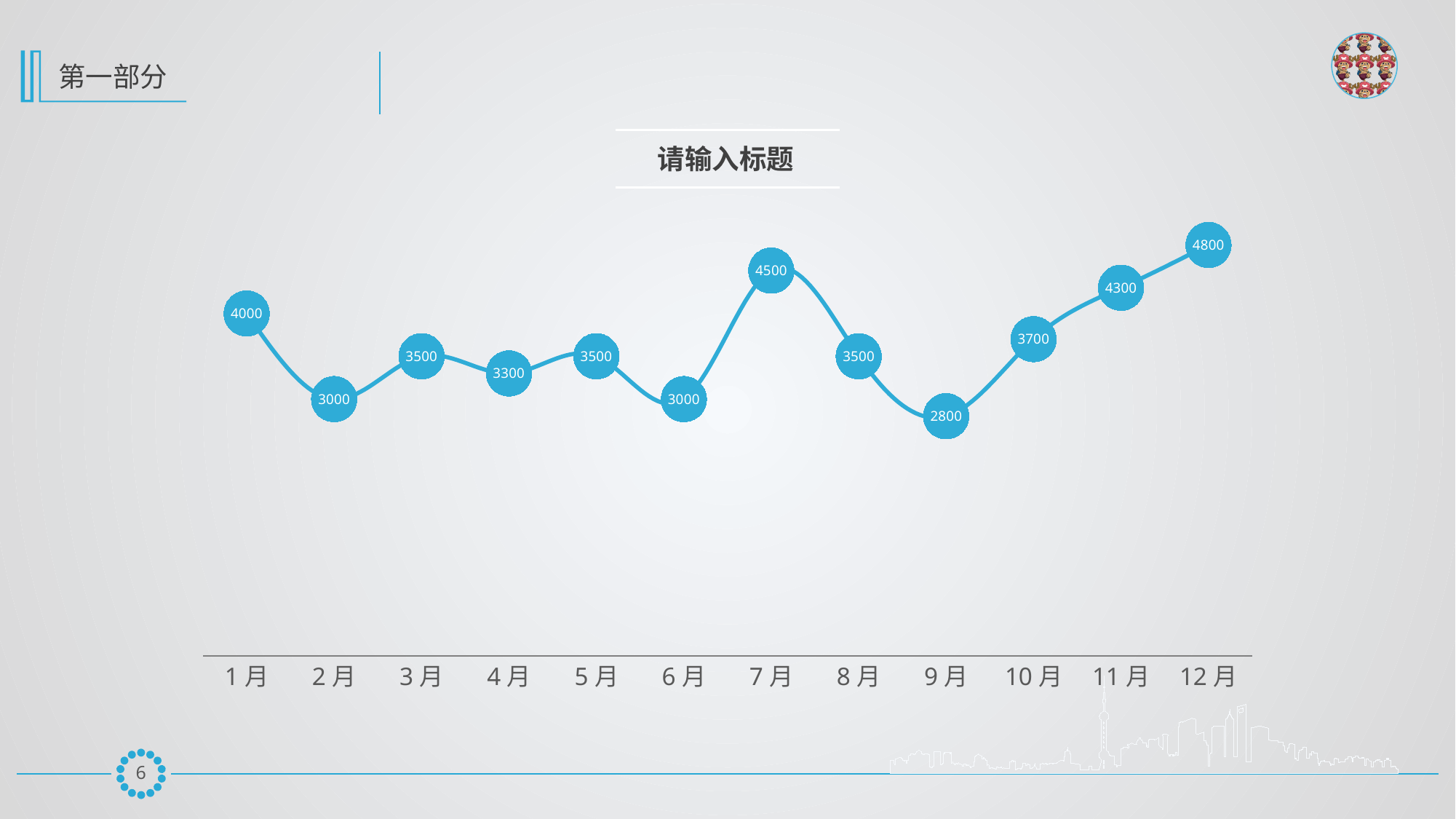
Which month has the highest value? 12月 How many months are plotted on the chart? 12 What is the value for 7月? 4500 What is the value for 4月? 3300 What is the title shown above the chart? 请输入标题 Which is larger, the value for 1月 or the value for 11月? 11月 What is the value for 10月? 3700 What is the difference between the values for 12月 and 9月? 2000 Do the values rise or fall from 9月 to 12月? rise What is the difference between the values for 7月 and 6月? 1500 Which month has the lowest value? 9月 What kind of chart is shown on the slide? line chart